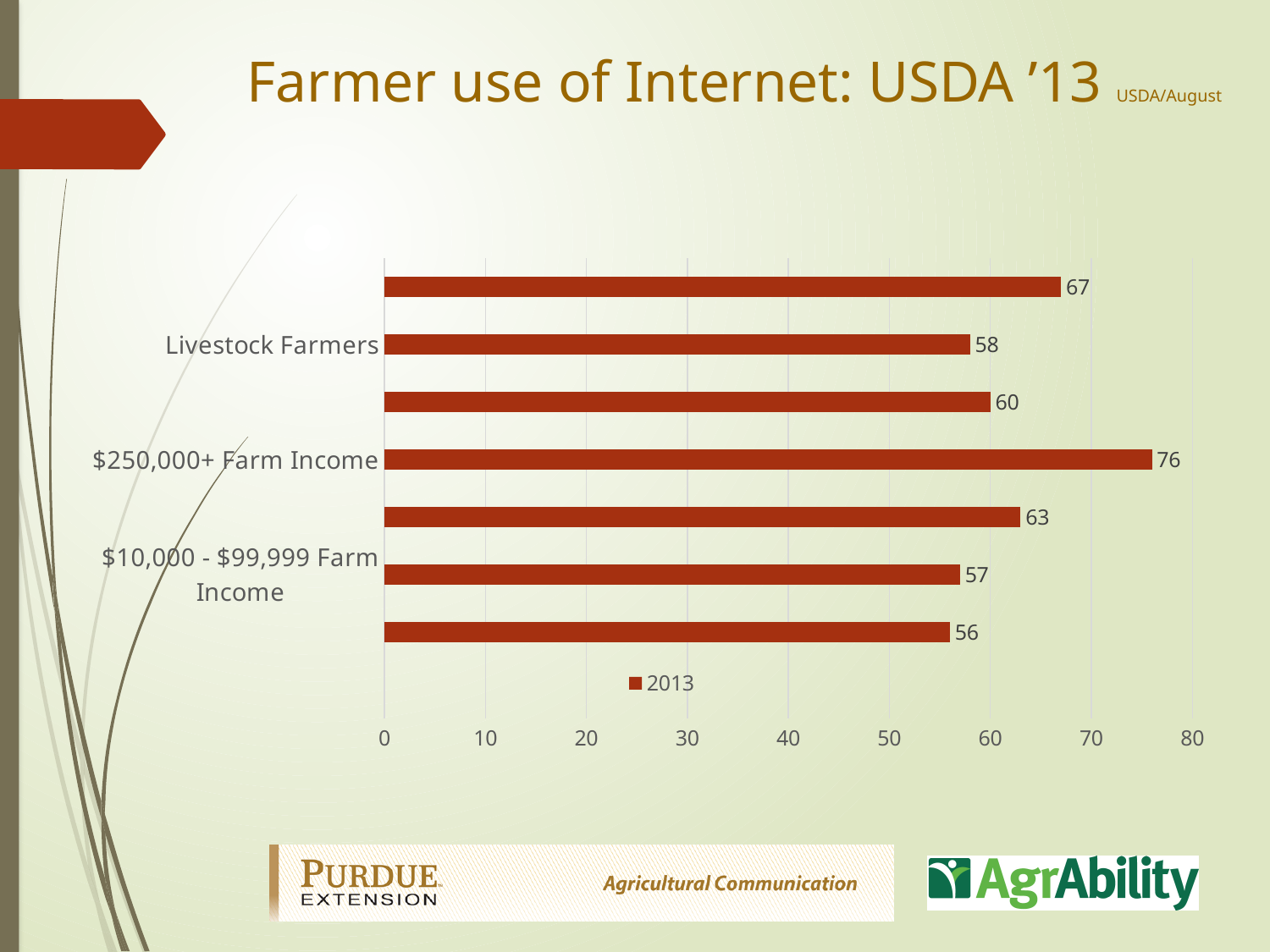
What is the difference between the values for $250,000+ Farm Income and Livestock Farmers? 18 Which is larger, the value for Livestock Farmers or the value for $10,000 - $99,999 Farm Income? Livestock Farmers What is the value for Livestock Farmers? 58 What kind of chart is shown on the slide? Bar chart How many series does the legend list? 1 What is the value for $250,000+ Farm Income? 76 What is the lowest value shown on any bar in the chart? 56 How many bars are plotted in the chart? 7 What is the value for $10,000 - $99,999 Farm Income? 57 Which labeled category has the highest value? $250,000+ Farm Income Is the value for $250,000+ Farm Income greater or less than 70? greater What is the series name shown in the legend? 2013